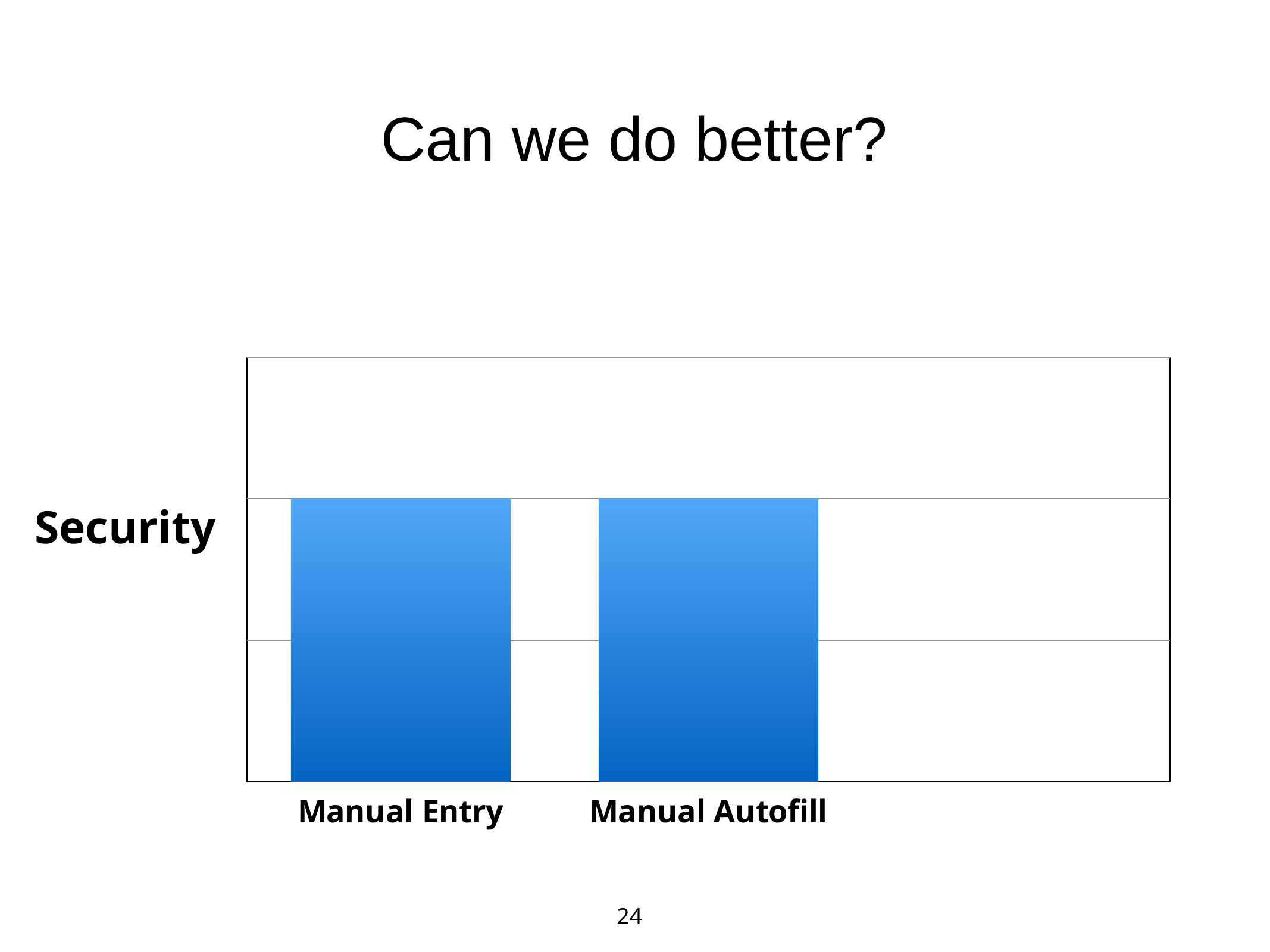
What kind of chart is shown on the slide? bar chart Do the bar heights rise, fall, or stay level from Manual Entry to Manual Autofill? stay level Do the bars for Manual Entry and Manual Autofill appear to be the same height? yes How many bars are plotted in the chart? 2 What label is shown on the vertical axis of the chart? Security What are the category labels on the x axis of the chart? Manual Entry, Manual Autofill What is the title of the slide containing the chart? Can we do better?